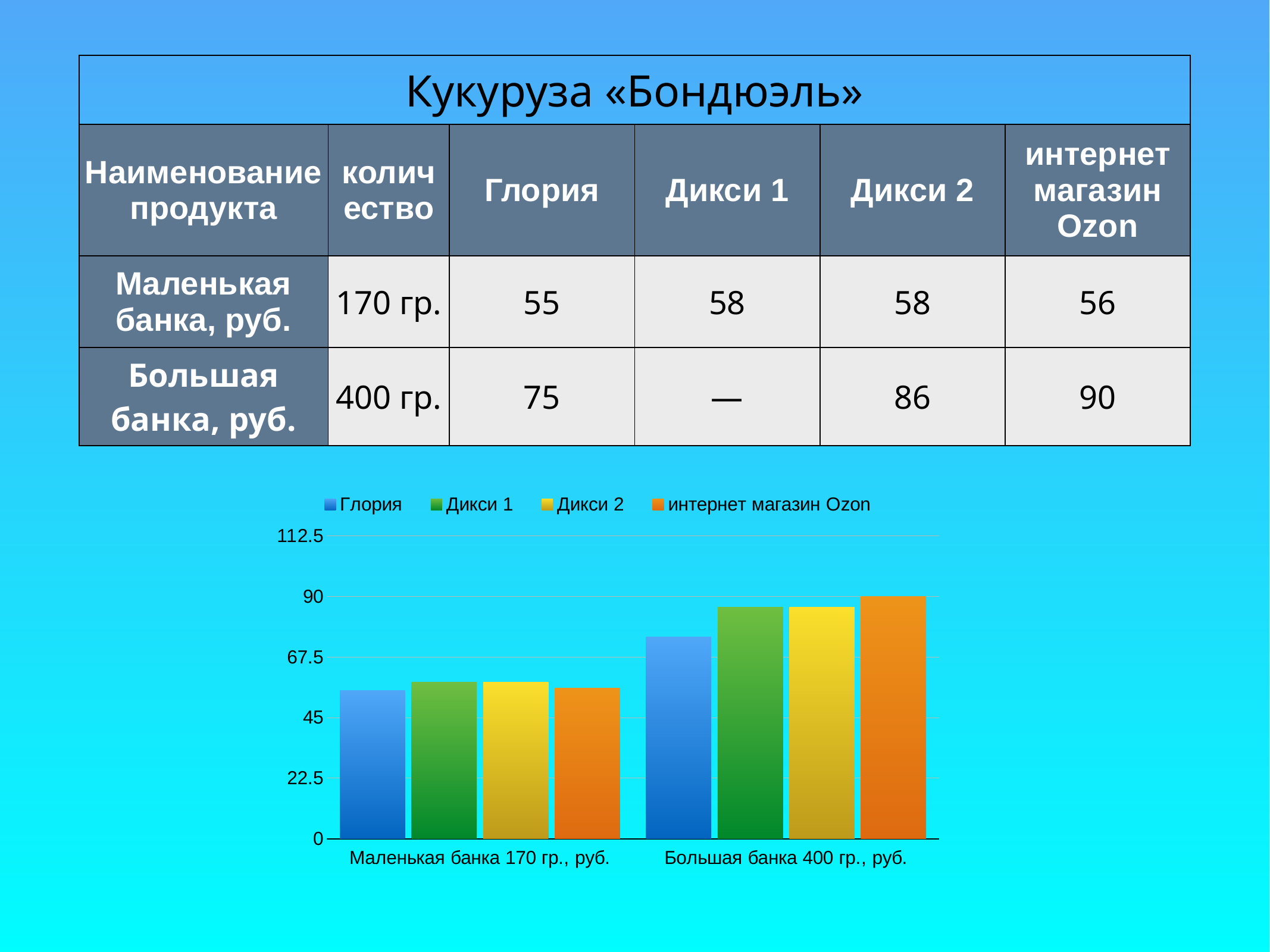
Which is larger for Большая банка 400 гр., руб.: Глория or интернет магазин Ozon? интернет магазин Ozon What is the value for интернет магазин Ozon for Большая банка 400 гр., руб.? 90 What colour represents интернет магазин Ozon in the chart legend? orange What is the value for Глория for Маленькая банка 170 гр., руб.? 55 How many series does the chart legend list? 4 What kind of chart is shown on the slide? bar chart What is the difference between интернет магазин Ozon and Глория for Большая банка 400 гр., руб.? 15 Do the values rise or fall from Маленькая банка 170 гр., руб. to Большая банка 400 гр., руб.? rise Is the value for Глория for Маленькая банка 170 гр., руб. greater or less than 67.5? less How many categories are shown on the x axis of the chart? 2 Which series has the highest value for Большая банка 400 гр., руб.? интернет магазин Ozon Is the value for Глория for Большая банка 400 гр., руб. greater or less than 67.5? greater